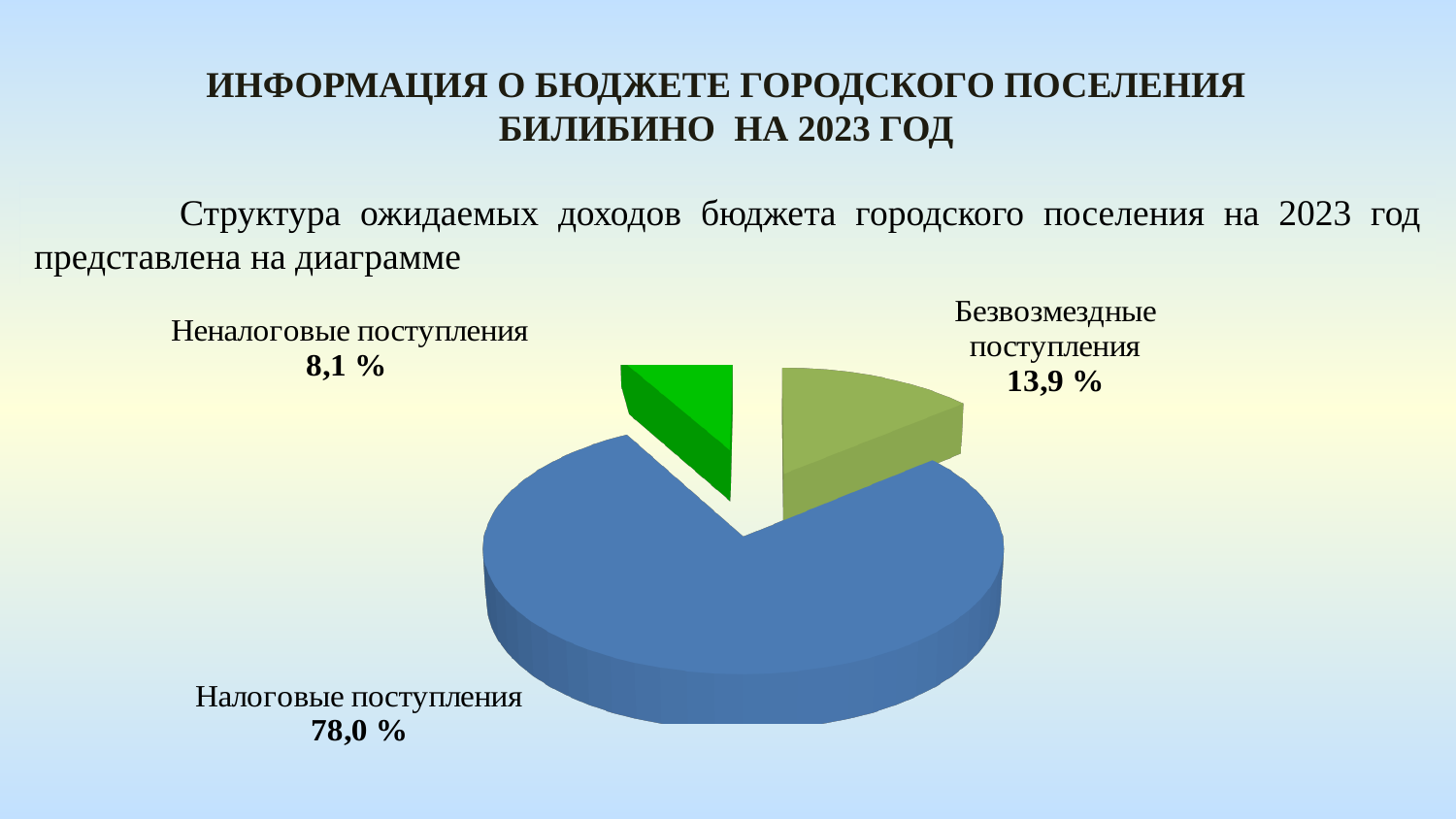
What share of the expected budget revenue comes from Безвозмездные поступления? 13,9 % Which category has the largest share of the pie? Налоговые поступления What share of the expected budget revenue comes from Неналоговые поступления? 8,1 % What is the difference in percentage points between Безвозмездные поступления and Неналоговые поступления? 5,8 What share of the expected budget revenue comes from Налоговые поступления? 78,0 % What kind of chart is shown on the slide? Pie chart What colour is the slice for Налоговые поступления? Blue What is the difference in percentage points between Налоговые поступления and Безвозмездные поступления? 64,1 How many categories are shown in the pie chart? 3 Which category has the smallest share of the pie? Неналоговые поступления What year does the budget revenue structure on the chart refer to? 2023 Which is larger: Безвозмездные поступления or Неналоговые поступления? Безвозмездные поступления